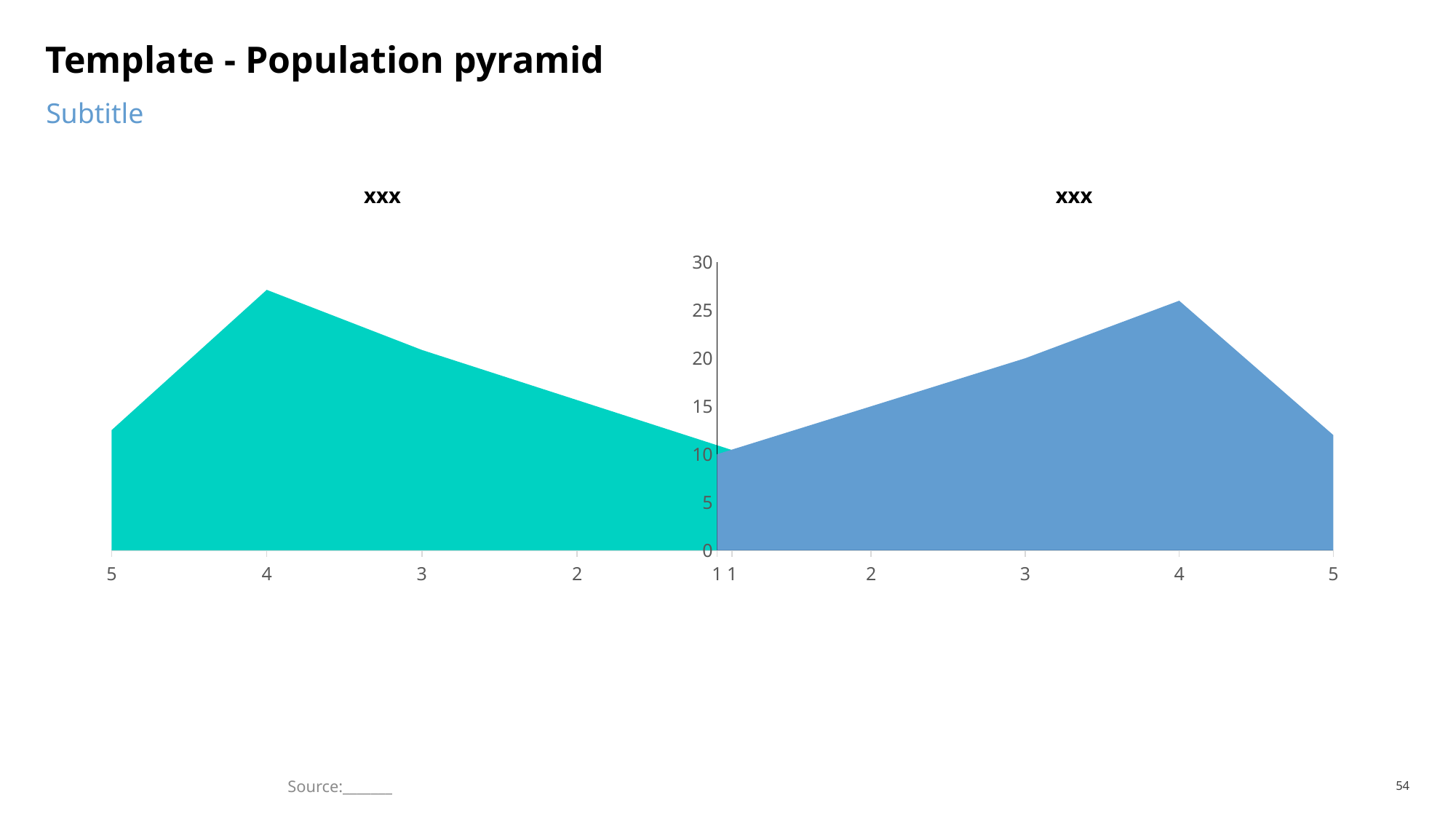
In the right chart, is the value for category 4 greater or less than 20? greater How many categories are plotted on the x axis of the right chart? 5 What kind of chart is the right chart on the slide? area chart In the left chart, is the value for category 5 greater or less than 10? greater In the right chart, is the value for category 5 greater or less than 15? less What kind of chart is the left chart on the slide? area chart In the right chart, which category has the highest value? 4 In the left chart, which is larger, the value for category 4 or the value for category 2? category 4 In the left chart, which category has the highest value? 4 What is the highest value shown on the vertical axis between the two charts? 30 In the right chart, do the values rise or fall from category 1 to category 4? rise